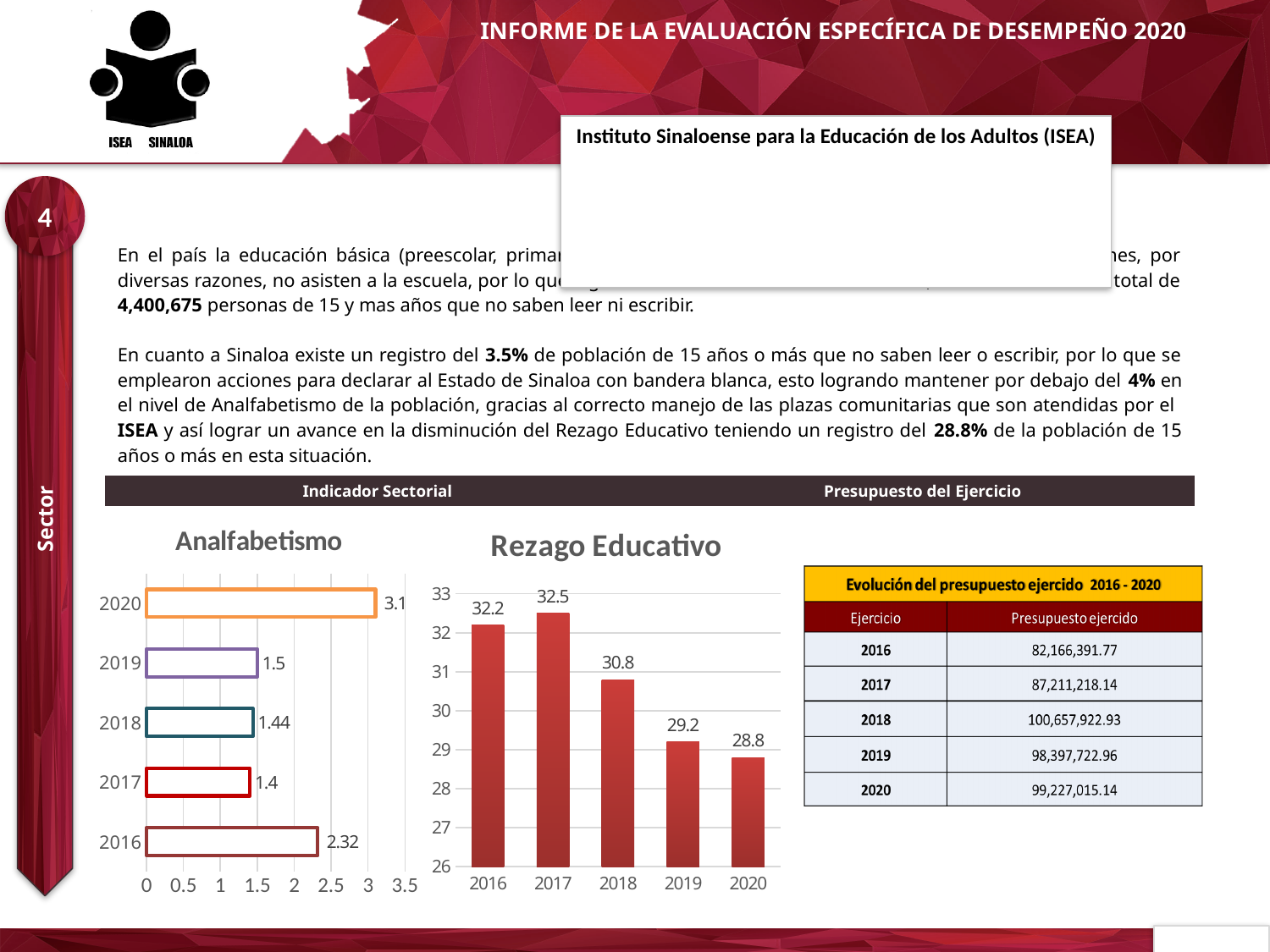
In the Rezago Educativo chart, what is the difference between the values for 2016 and 2020? 3.4 In the Rezago Educativo chart, which year has the highest value? 2017 In the Analfabetismo chart, how many years are shown? 5 In the Analfabetismo chart, which year has the lowest value? 2017 In the Analfabetismo chart, what is the value for 2016? 2.32 In the Rezago Educativo chart, do the values rise or fall from 2017 to 2020? fall In the Rezago Educativo chart, what is the value for 2018? 30.8 In the Analfabetismo chart, what is the value for 2020? 3.1 In the Rezago Educativo chart, which year has the lowest value? 2020 In the Analfabetismo chart, what is the difference between the values for 2020 and 2019? 1.6 In the Analfabetismo chart, which year has the highest value? 2020 What kind of chart is the Rezago Educativo chart? bar chart